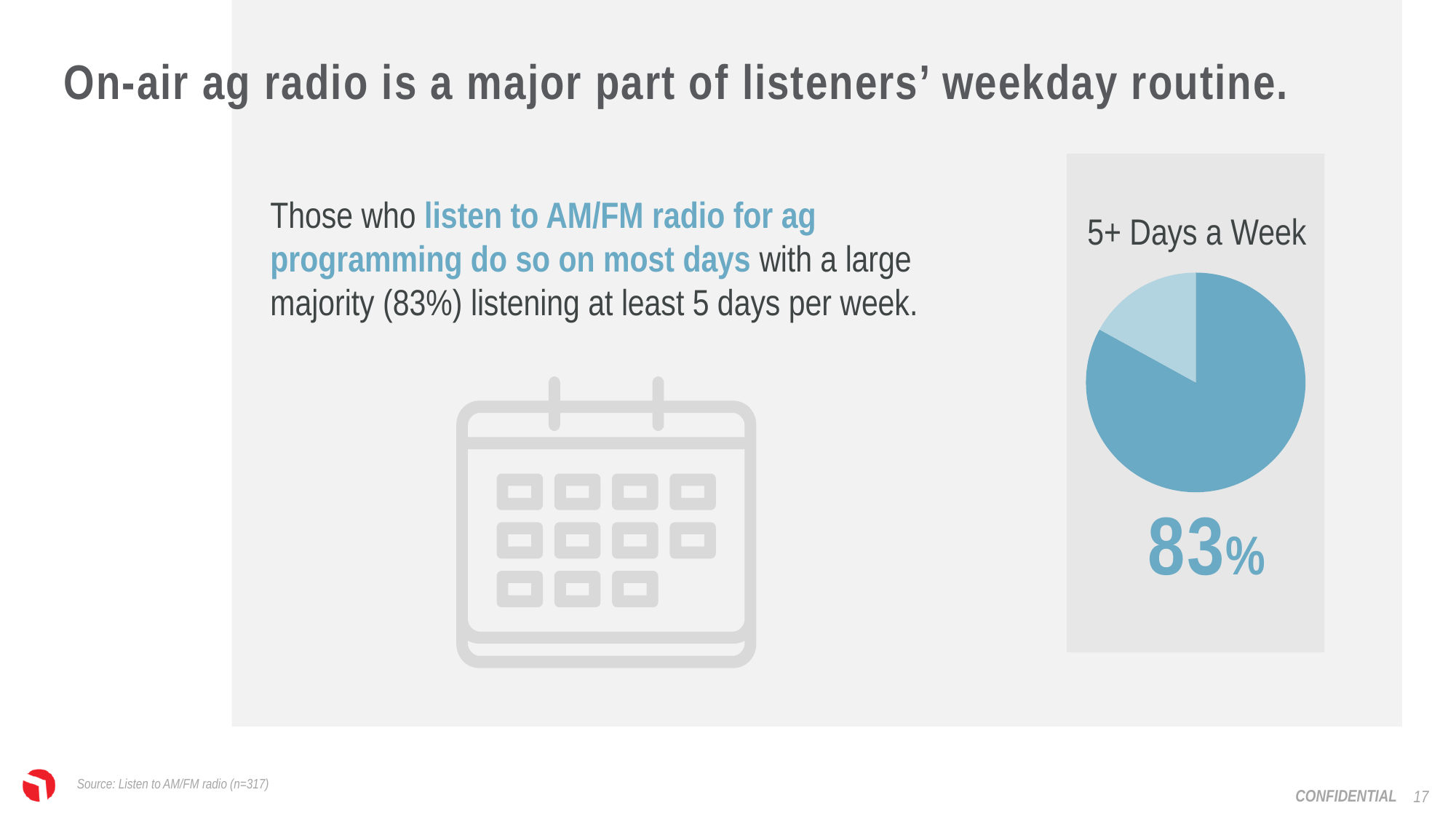
What share of the pie does the '5+ Days a Week' slice represent? 83% What percentage of listeners listen to ag radio 5+ days a week according to the pie chart? 83% How many slices does the pie chart have? 2 What kind of chart is shown on the slide? pie chart What is the label shown above the pie chart? 5+ Days a Week Which category is the largest slice in the pie chart? 5+ Days a Week What colour is the slice representing 83% in the pie chart? dark blue Which slice of the pie chart is larger, the dark blue slice or the light blue slice? the dark blue slice